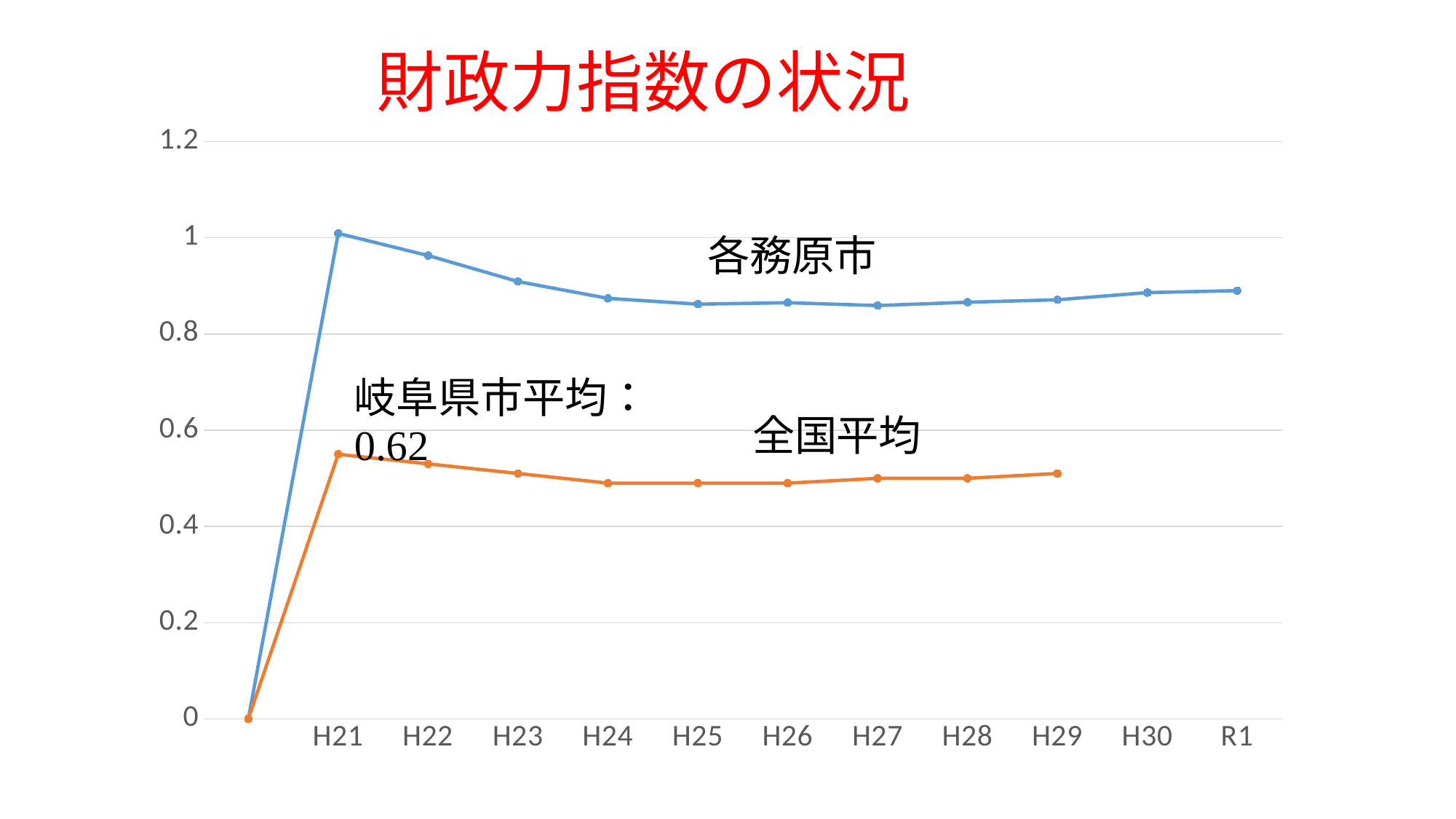
Is the value for 各務原市 at H27 greater or less than 1? less What value is given for 岐阜県市平均 in the annotation on the chart? 0.62 In which labeled year does 各務原市 reach its highest value? H21 How many series are plotted on the chart? 2 Is the value for 各務原市 at R1 greater or less than 0.8? greater How many labeled year categories are shown on the x axis? 11 At H25, which series has the larger value, 各務原市 or 全国平均? 各務原市 What kind of chart is shown on the slide? line chart Is the value for 全国平均 at H24 greater or less than 0.6? less Does the value for 各務原市 rise or fall from H21 to H24? fall What is the title of the chart? 財政力指数の状況